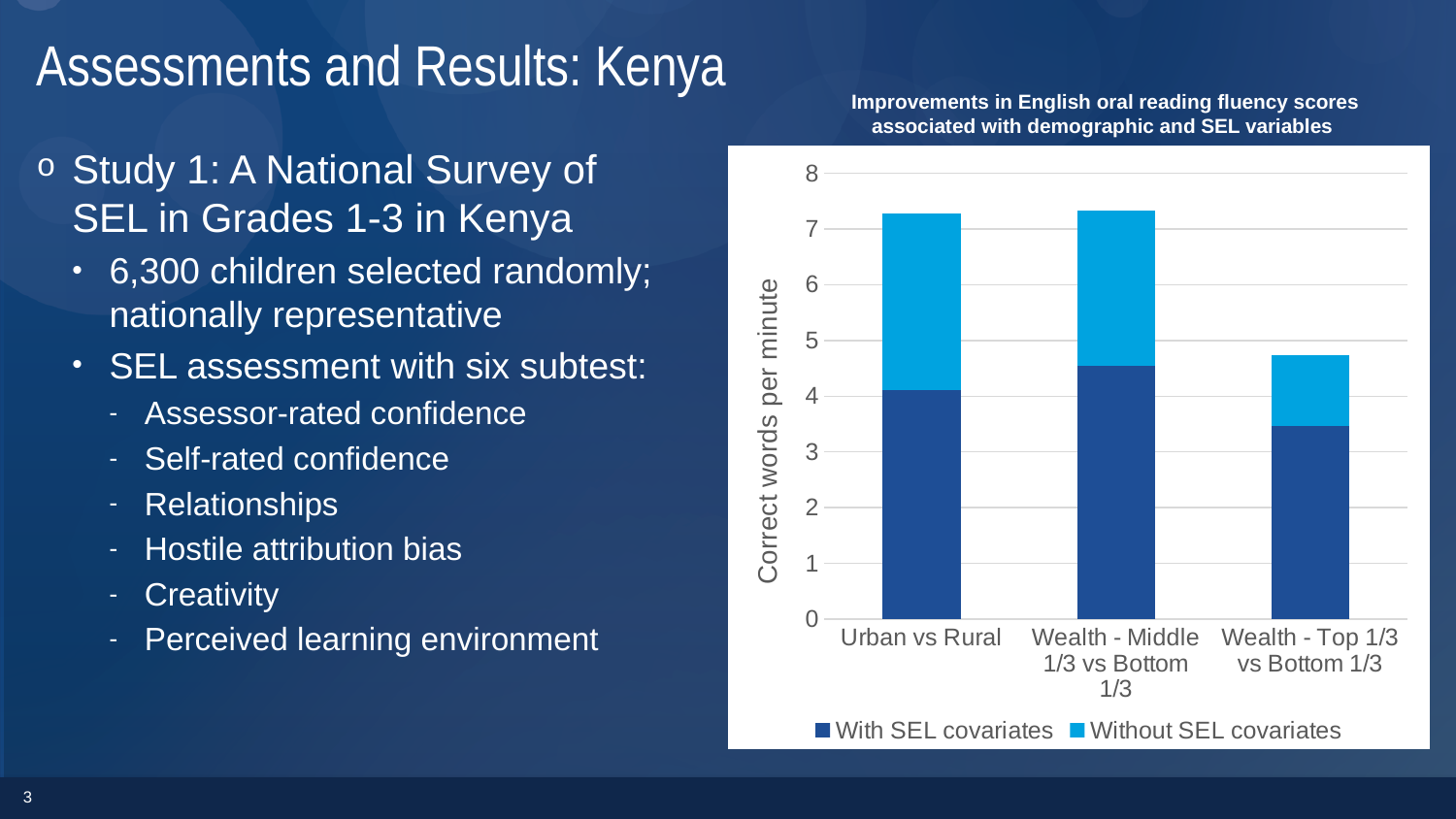
Which category has the highest value for 'With SEL covariates'? Wealth - Middle 1/3 vs Bottom 1/3 How many categories are shown on the x axis of the chart? 3 What is the label on the y axis of the chart? Correct words per minute Is the total bar height for 'Wealth - Top 1/3 vs Bottom 1/3' greater or less than 5? less What is the title of the chart? Improvements in English oral reading fluency scores associated with demographic and SEL variables Which is larger: the 'With SEL covariates' value for 'Urban vs Rural' or for 'Wealth - Top 1/3 vs Bottom 1/3'? Urban vs Rural Is the 'With SEL covariates' value for 'Wealth - Top 1/3 vs Bottom 1/3' greater or less than 4? less Which category has the lowest total bar height in the chart? Wealth - Top 1/3 vs Bottom 1/3 Which category has the lowest value for 'With SEL covariates'? Wealth - Top 1/3 vs Bottom 1/3 How many series does the chart's legend list? 2 What kind of chart is shown on the slide? Stacked bar chart Is the total bar height for 'Urban vs Rural' greater or less than 7? greater